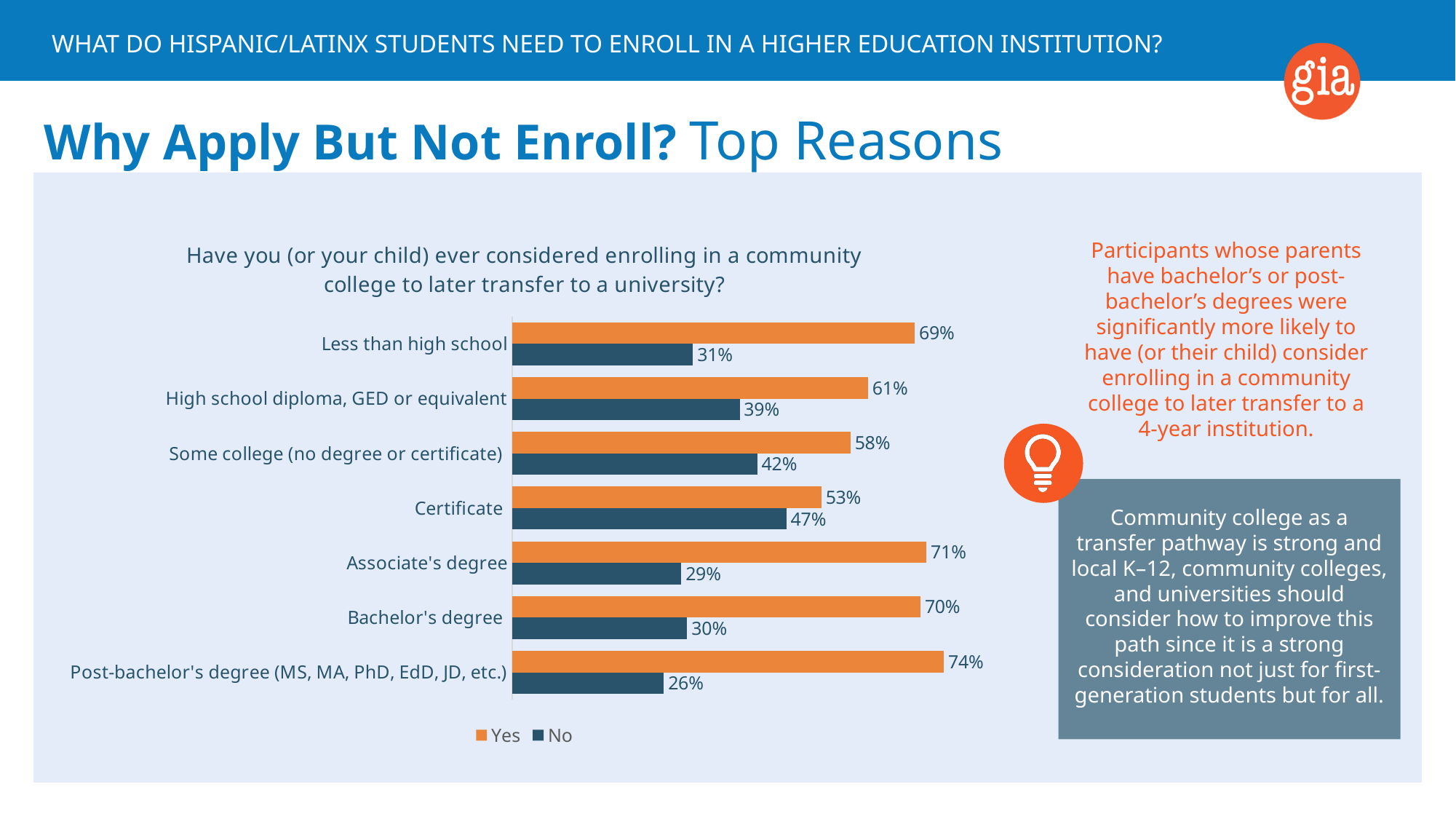
What is the 'No' value for Certificate? 47% How many series does the legend list? 2 What is the 'Yes' value for Less than high school? 69% What is the 'Yes' value for Associate's degree? 71% What kind of chart is shown on the slide? Bar chart Which category has the lowest 'Yes' value? Certificate What colour represents the 'No' series in the chart? Dark blue Which category has the highest 'No' value? Certificate Which category has the highest 'Yes' value? Post-bachelor's degree (MS, MA, PhD, EdD, JD, etc.) How many categories are shown on the chart? 7 Which is larger: the 'Yes' value for High school diploma, GED or equivalent or the 'Yes' value for Some college (no degree or certificate)? High school diploma, GED or equivalent What is the difference between the 'Yes' and 'No' values for Bachelor's degree? 40%